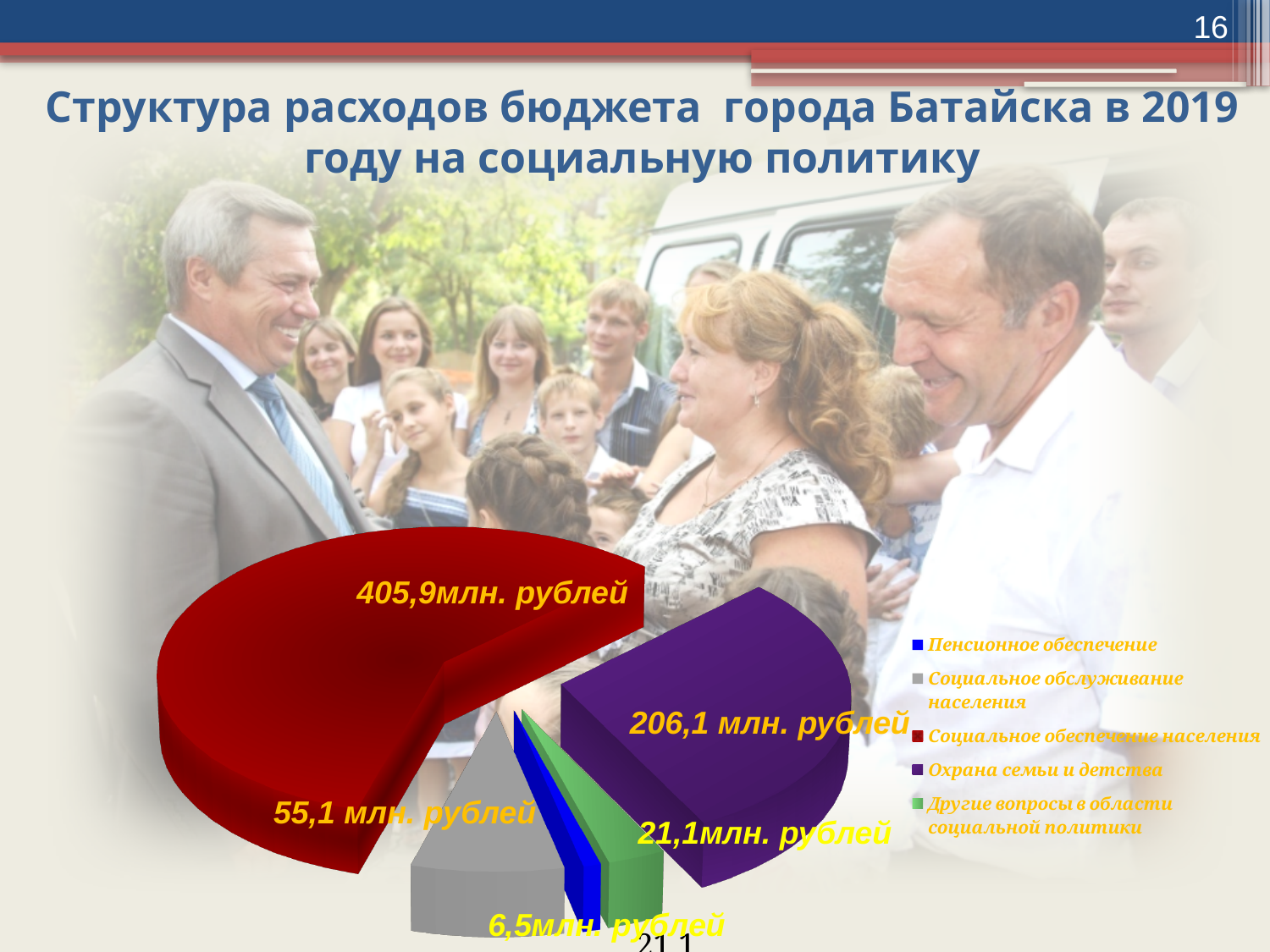
What is the value for Социальное обслуживание населения? 55,1 млн. рублей Which category has the largest slice of the pie? Социальное обеспечение населения What colour is the slice for Охрана семьи и детства? purple What is the value for Пенсионное обеспечение? 6,5 млн. рублей How many entries does the legend of the pie chart list? 5 What kind of chart is shown on the slide? pie chart What is the difference between the values for Социальное обеспечение населения and Охрана семьи и детства? 199,8 млн. рублей What is the value for Социальное обеспечение населения? 405,9 млн. рублей Which is larger: Социальное обслуживание населения or Другие вопросы в области социальной политики? Социальное обслуживание населения What is the value for Охрана семьи и детства? 206,1 млн. рублей How many slices does the pie chart have? 5 Which category has the smallest slice of the pie? Пенсионное обеспечение